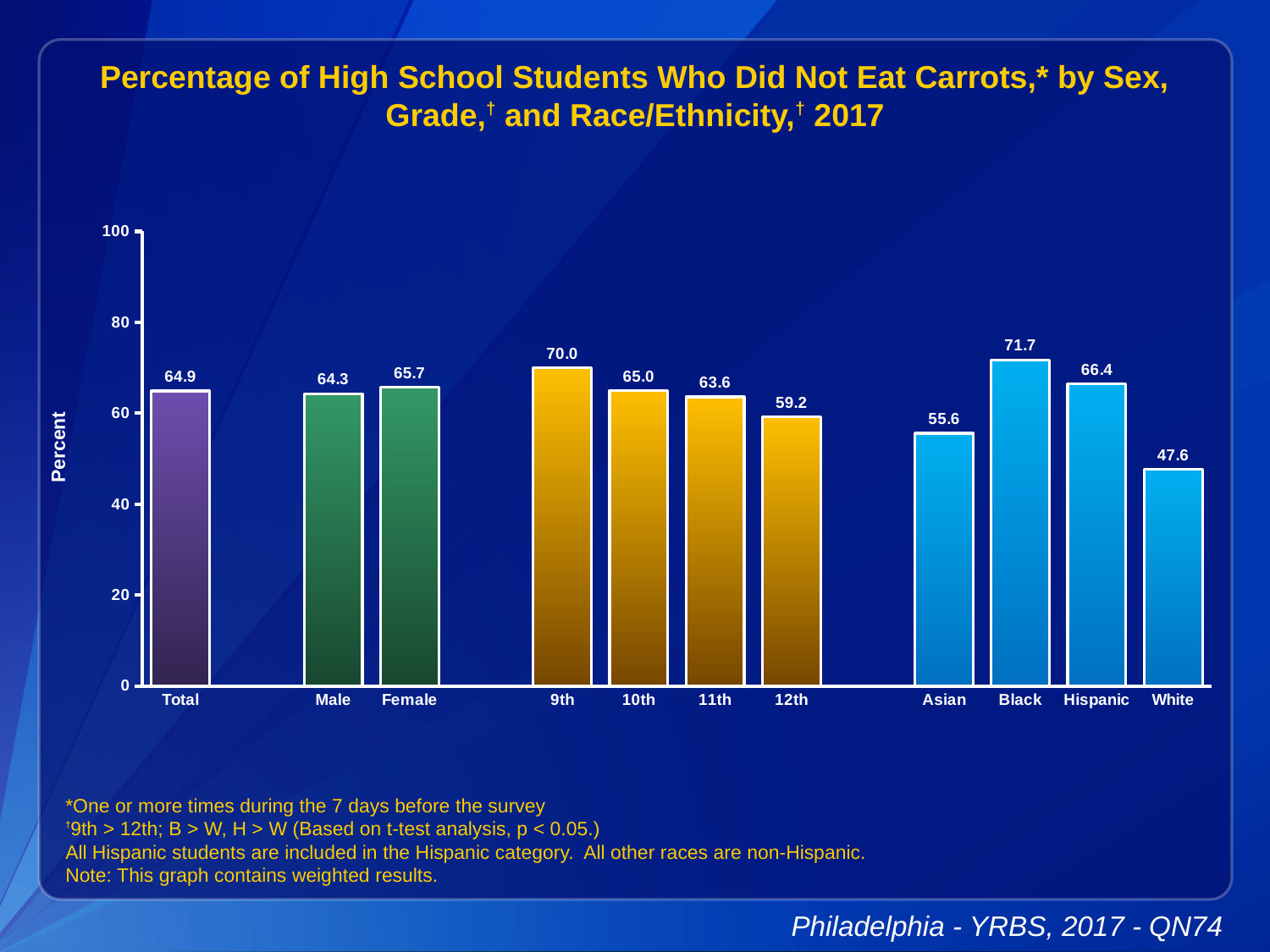
Do the values rise or fall from 9th grade to 12th grade? Fall How many bars are shown in the chart? 11 What is the value for 12th grade? 59.2 What is the value for Asian students? 55.6 What is the difference between the values for 9th and 12th grade? 10.8 What kind of chart is this? Bar chart Which category has the lowest value? White Which category has the highest value? Black What is the value for Total? 64.9 What is the value for Female? 65.7 What is the difference between the values for Male and Female? 1.4 Which is larger, the value for Hispanic or the value for Asian? Hispanic